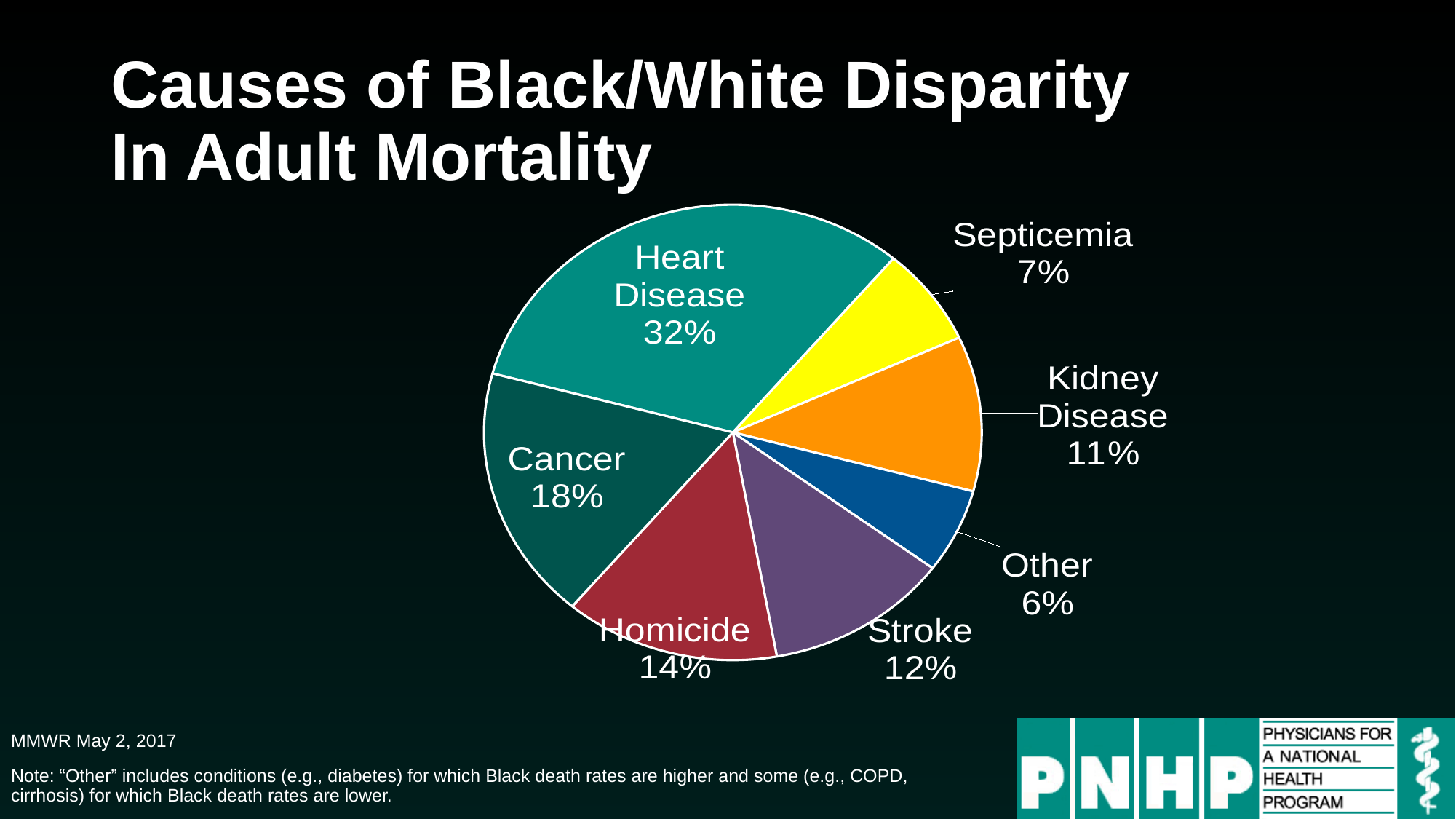
Which category has the smallest slice of the pie? Other What kind of chart is shown on the slide? pie chart Which category has the largest slice of the pie? Heart Disease What is the difference between the Stroke and Kidney Disease percentages? 1% Which is larger, the Stroke slice or the Septicemia slice? Stroke How many slices does the pie chart have? 7 What is the title of the chart on the slide? Causes of Black/White Disparity In Adult Mortality What share of the pie does Heart Disease account for? 32% What is the difference between the Heart Disease and Cancer percentages? 14% What is the value shown for Cancer? 18% What is the value shown for Kidney Disease? 11% What is the value shown for Homicide? 14%